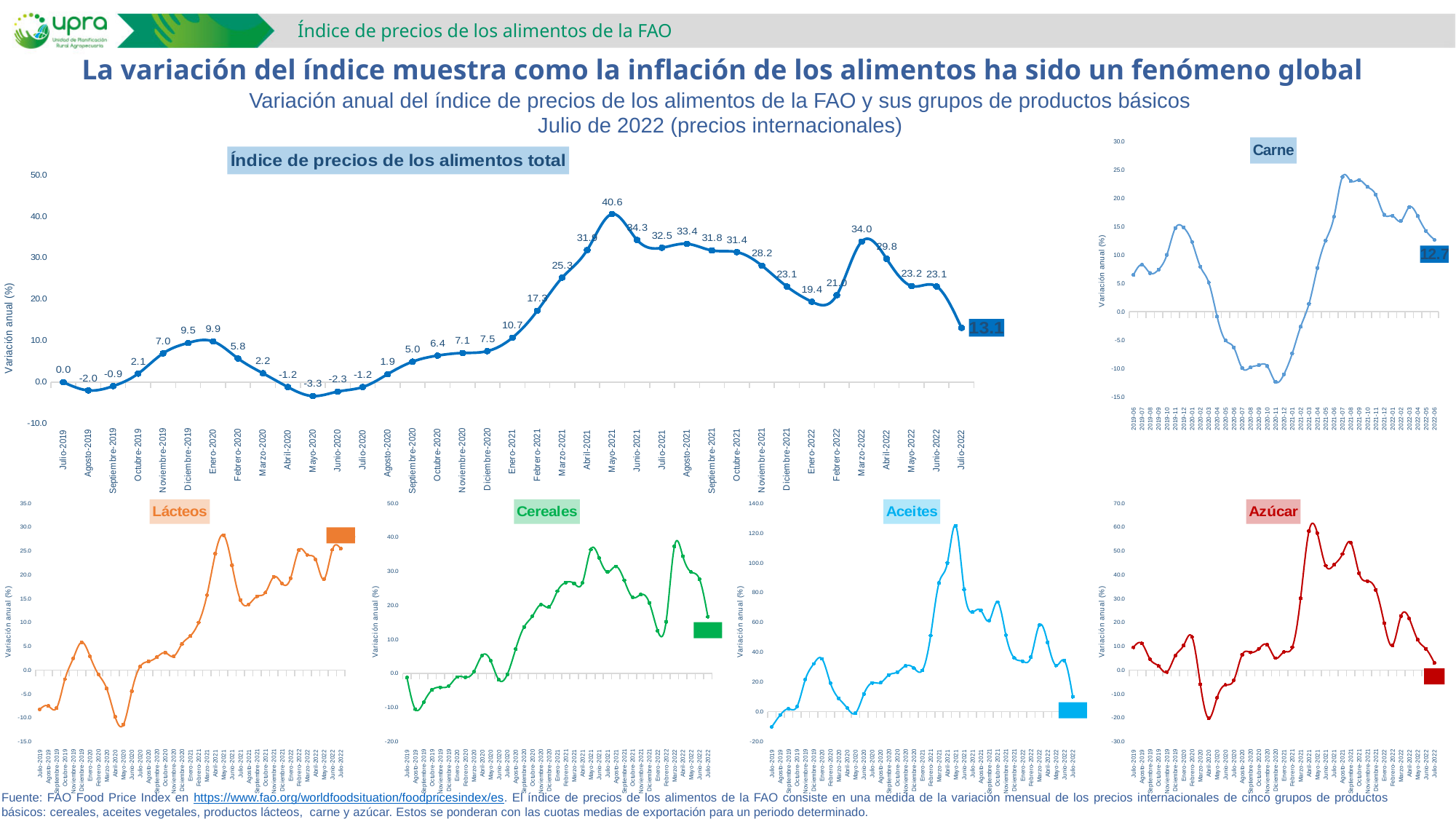
What kind of chart is the 'Índice de precios de los alimentos total' chart? Line chart In the 'Índice de precios de los alimentos total' chart, which is larger, the value for Marzo-2022 or Abril-2022? Marzo-2022 In the 'Índice de precios de los alimentos total' chart, what is the value for Mayo-2021? 40.6 In the 'Índice de precios de los alimentos total' chart, do the values rise or fall from Enero-2021 to Mayo-2021? Rise In the 'Índice de precios de los alimentos total' chart, what is the difference between the values for Mayo-2021 and Julio-2022? 27.5 In the 'Carne' chart, what is the value shown for the last point (2022-06)? 12.7 In the 'Azúcar' chart, is the highest value greater or less than 50.0? greater In the 'Índice de precios de los alimentos total' chart, what is the value for Julio-2022? 13.1 In the 'Carne' chart, is the peak value in 2021 greater or less than 20.0? greater In the 'Cereales' chart, is the value for the last point (Julio-2022) greater or less than 20.0? less In the 'Índice de precios de los alimentos total' chart, which month has the lowest value? Mayo-2020 In the 'Índice de precios de los alimentos total' chart, which month has the highest value? Mayo-2021